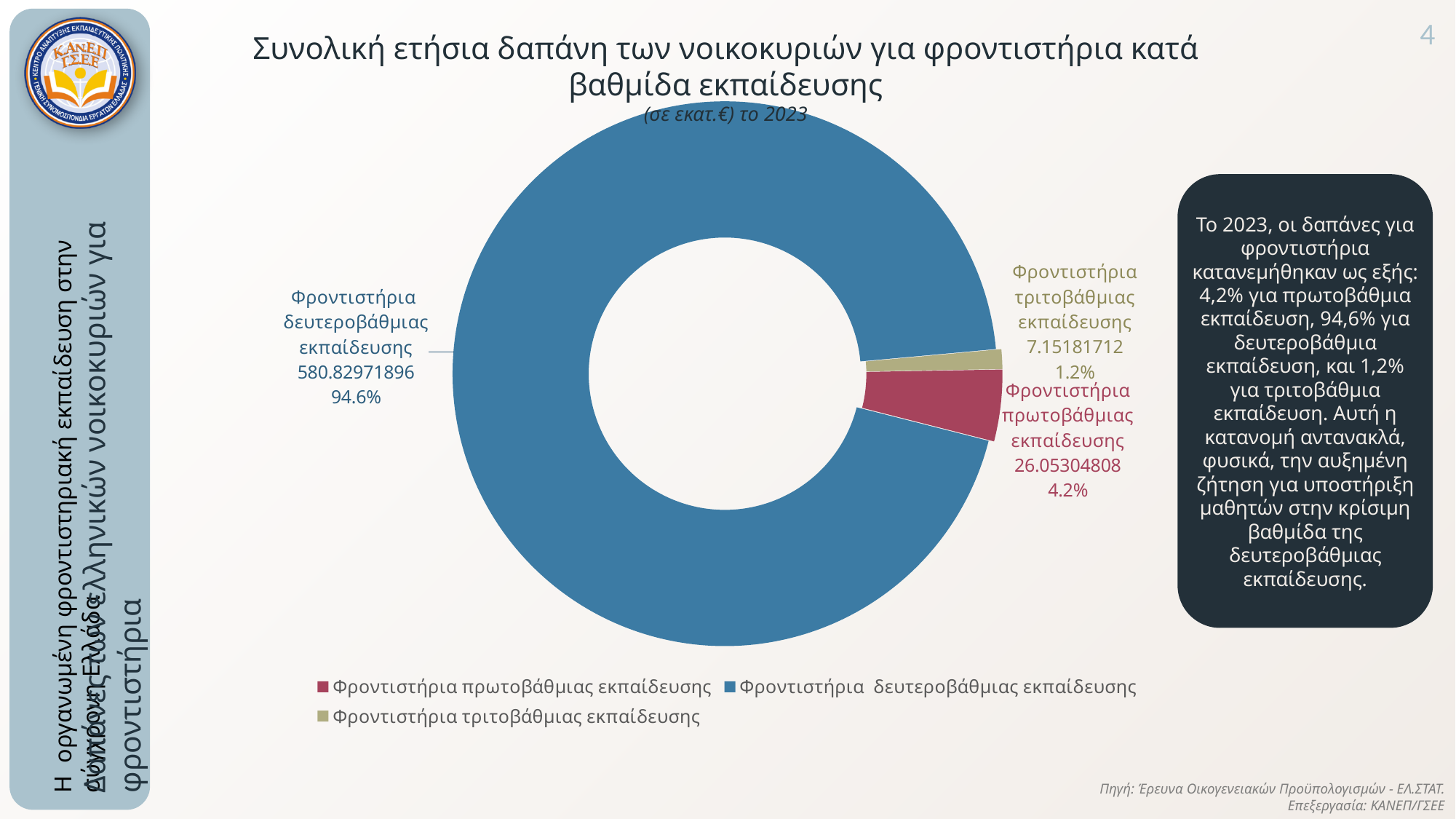
What is the value for Φροντιστήρια πρωτοβάθμιας εκπαίδευσης? 26.05304808 Which category has the largest value? Φροντιστήρια δευτεροβάθμιας εκπαίδευσης What share of the chart does Φροντιστήρια πρωτοβάθμιας εκπαίδευσης represent? 4.2% What is the value for Φροντιστήρια τριτοβάθμιας εκπαίδευσης? 7.15181712 How many categories does the chart show? 3 What share of the chart does Φροντιστήρια δευτεροβάθμιας εκπαίδευσης represent? 94.6% What colour is the slice for Φροντιστήρια τριτοβάθμιας εκπαίδευσης? Olive/khaki What share of the chart does Φροντιστήρια τριτοβάθμιας εκπαίδευσης represent? 1.2% What type of chart is shown on the slide? Doughnut (pie) chart Which category has the smallest value? Φροντιστήρια τριτοβάθμιας εκπαίδευσης Which is larger: the value for Φροντιστήρια πρωτοβάθμιας εκπαίδευσης or Φροντιστήρια τριτοβάθμιας εκπαίδευσης? Φροντιστήρια πρωτοβάθμιας εκπαίδευσης What is the value for Φροντιστήρια δευτεροβάθμιας εκπαίδευσης? 580.82971896